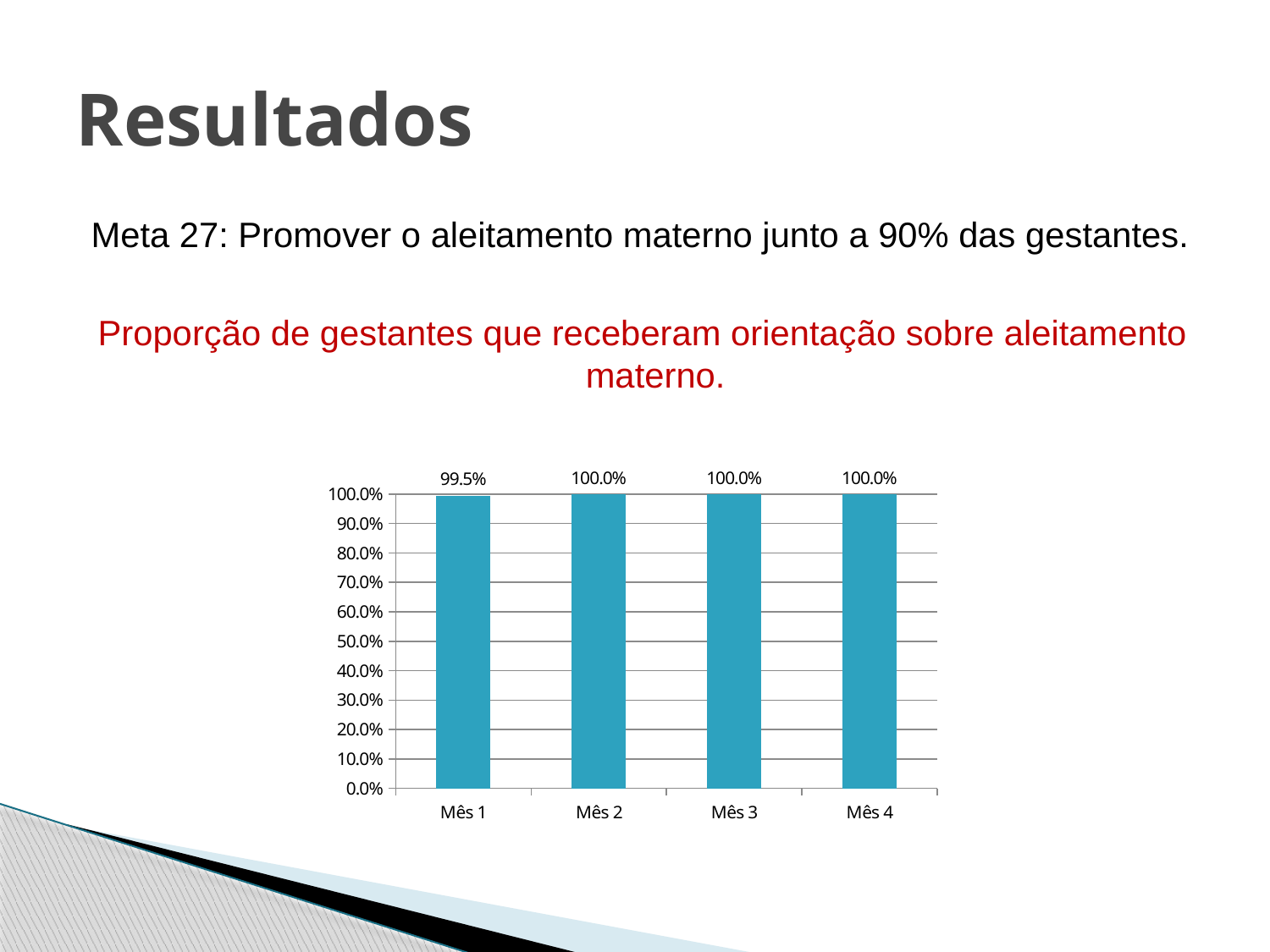
What kind of chart is shown on the slide? bar chart What colour are the bars in the chart? blue What is the value for Mês 2? 100.0% Which month has the lowest value? Mês 1 How many months are shown on the x axis? 4 What is the difference between the values for Mês 2 and Mês 1? 0.5% What is the highest tick label on the y axis? 100.0% Which is larger, the value for Mês 1 or the value for Mês 3? Mês 3 What is the value for Mês 4? 100.0% What is the value for Mês 1? 99.5% Does the value rise or fall from Mês 1 to Mês 2? rise Is the value for Mês 3 greater or less than 90.0%? greater